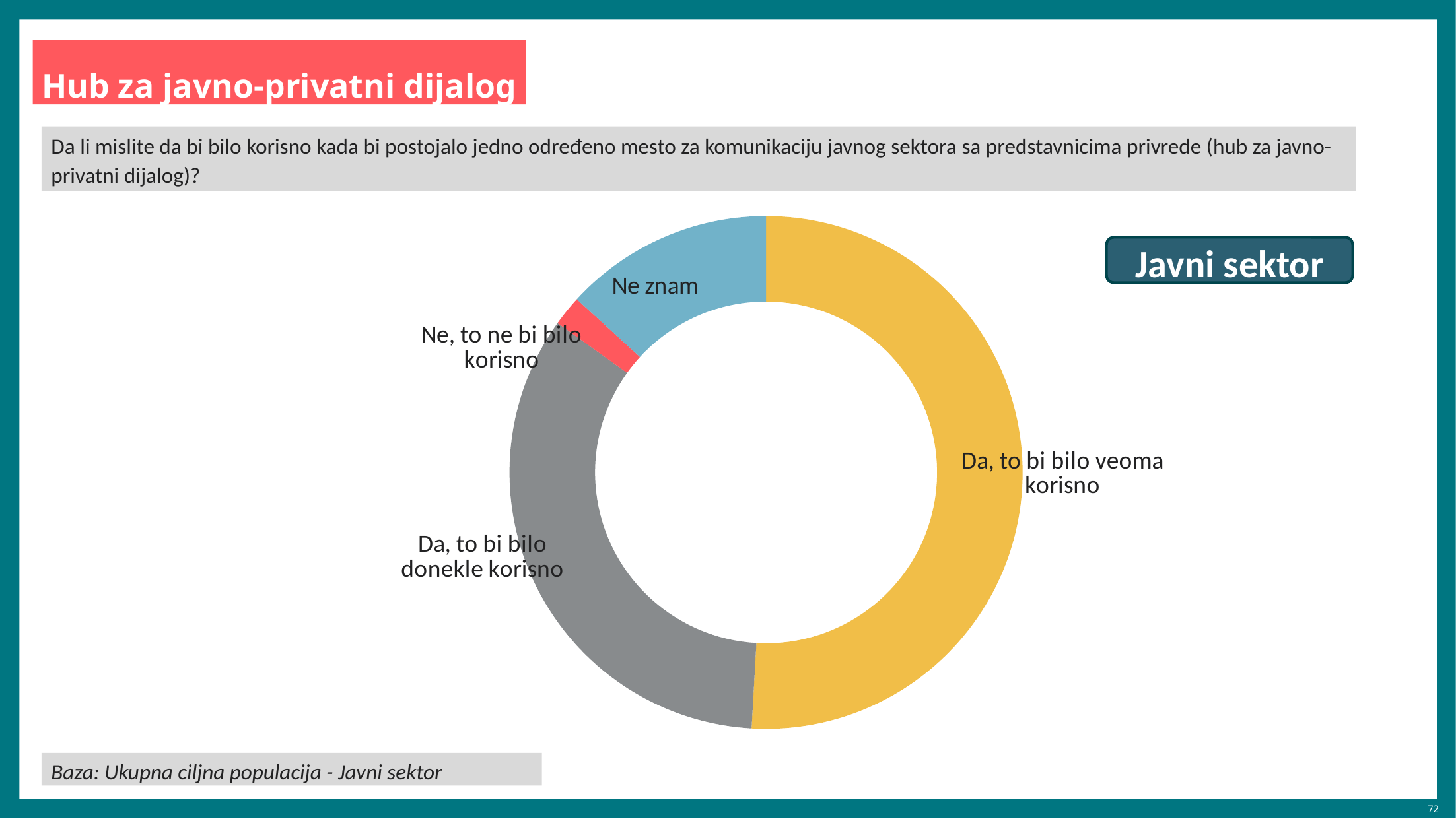
Which slice is larger: "Da, to bi bilo donekle korisno" or "Ne znam"? Da, to bi bilo donekle korisno What colour is the "Ne znam" slice of the chart? light blue Which slice is larger: "Ne znam" or "Ne, to ne bi bilo korisno"? Ne znam Which category has the smallest slice in the chart? Ne, to ne bi bilo korisno What kind of chart is shown on the slide? doughnut chart What is the title of the slide containing the chart? Hub za javno-privatni dijalog How many categories (slices) does the chart have? 4 Which slice is larger: "Da, to bi bilo veoma korisno" or "Da, to bi bilo donekle korisno"? Da, to bi bilo veoma korisno Which category has the largest slice in the chart? Da, to bi bilo veoma korisno